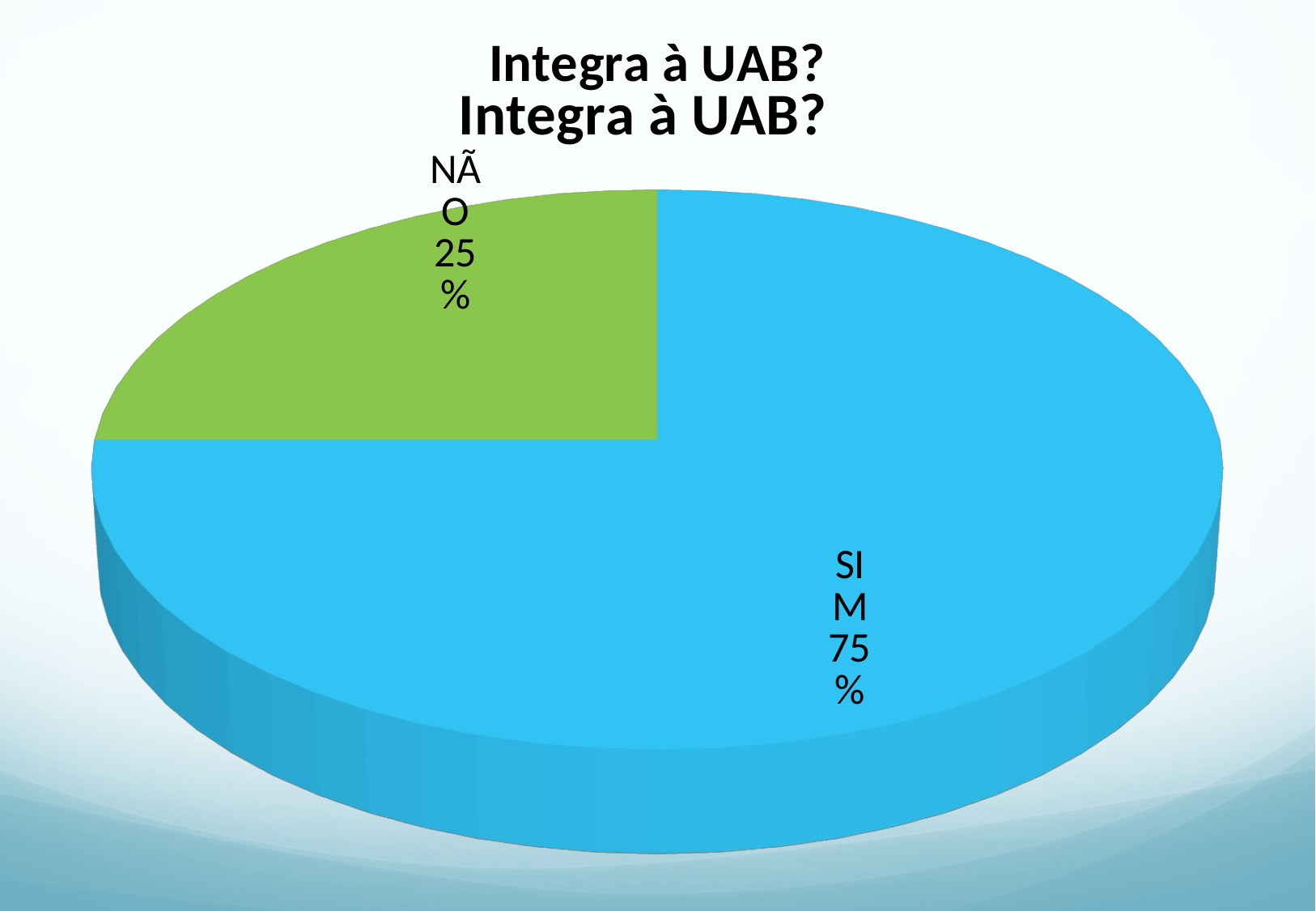
What kind of chart is shown on the slide? Pie chart What is the difference in percentage points between the SIM and NÃO slices? 50 What share of the pie does SIM represent? 75% Which slice is the largest in the pie chart? SIM What share of the pie does NÃO represent? 25% What is the title of the chart? Integra à UAB? How many slices does the pie chart have? 2 Which slice is the smallest in the pie chart? NÃO What colour is the SIM slice? Blue Which slice is larger, SIM or NÃO? SIM